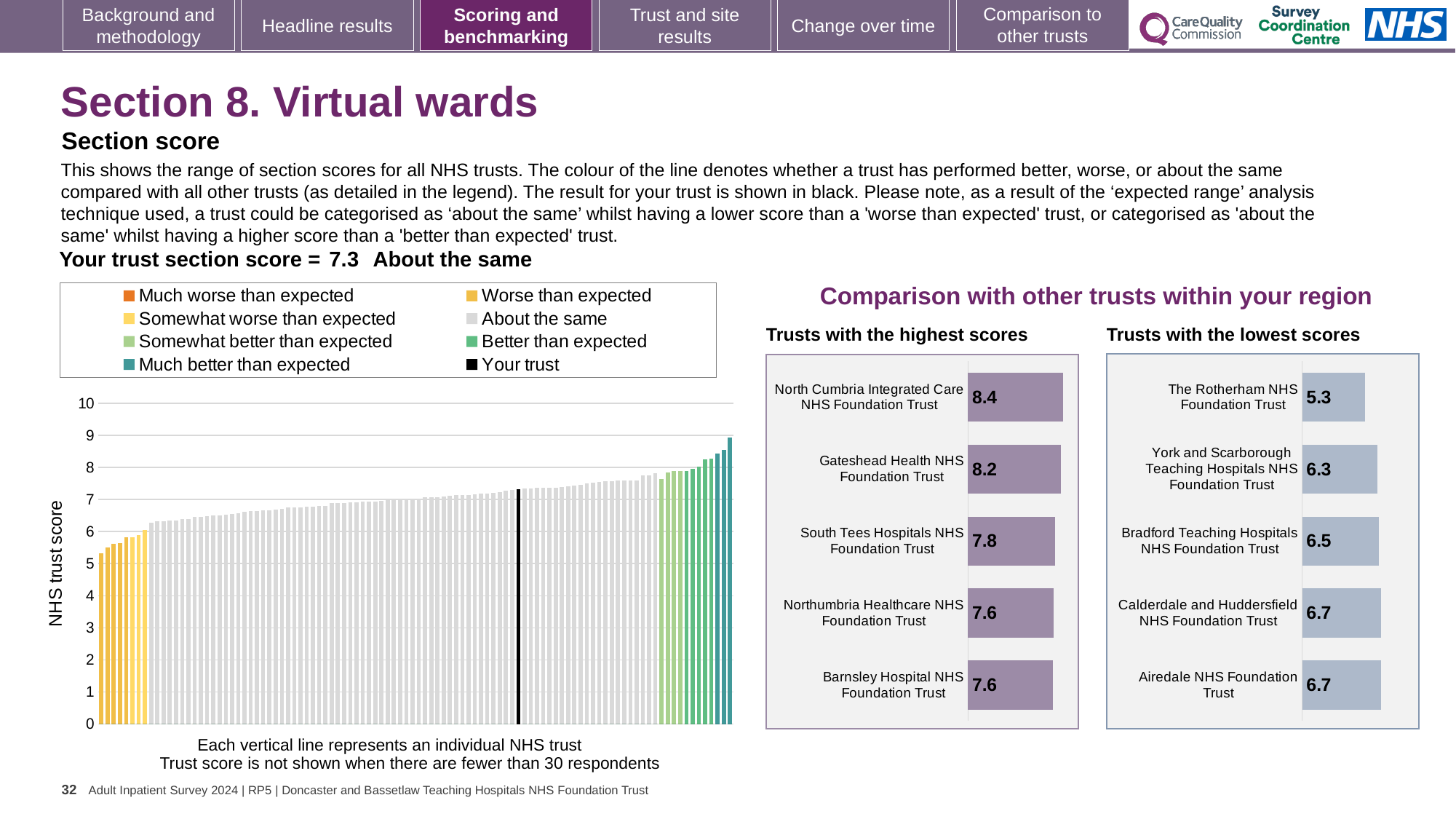
In the 'Trusts with the highest scores' chart, what is the score for North Cumbria Integrated Care NHS Foundation Trust? 8.4 How many entries does the legend of the NHS trust score chart on the left list? 8 What kind of chart is the NHS trust score chart on the left of the slide? Bar chart In the 'Trusts with the lowest scores' chart, what is the score for The Rotherham NHS Foundation Trust? 5.3 In the 'Trusts with the highest scores' chart, which trust has the highest score? North Cumbria Integrated Care NHS Foundation Trust In the 'Trusts with the lowest scores' chart, how much higher is the score of York and Scarborough Teaching Hospitals NHS Foundation Trust than that of The Rotherham NHS Foundation Trust? 1.0 In the 'Trusts with the highest scores' chart, what is the difference between the scores of North Cumbria Integrated Care NHS Foundation Trust and Gateshead Health NHS Foundation Trust? 0.2 In the 'Trusts with the lowest scores' chart, which trust has the lowest score? The Rotherham NHS Foundation Trust How many trusts are shown in the 'Trusts with the highest scores' chart? 5 In the NHS trust score chart on the left, is the value of the tallest bar greater or less than 8? greater Which has the larger score: South Tees Hospitals NHS Foundation Trust in the highest-scores chart or Bradford Teaching Hospitals NHS Foundation Trust in the lowest-scores chart? South Tees Hospitals NHS Foundation Trust In the NHS trust score chart on the left, do the values rise or fall from left to right? Rise